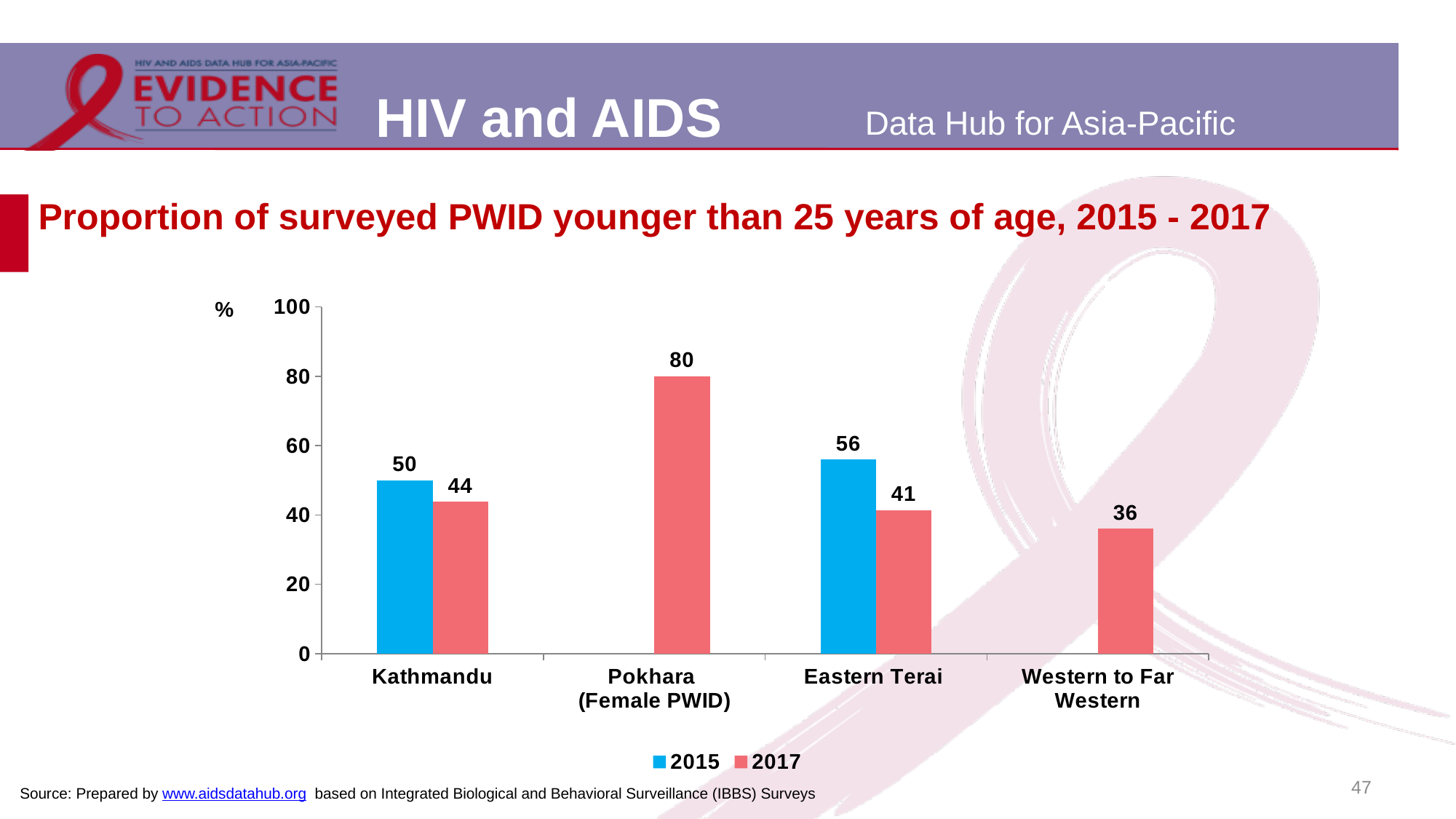
How many categories are shown on the x axis? 4 Which category has the highest 2017 value? Pokhara (Female PWID) What is the 2015 value for Kathmandu? 50 Which category has the lowest 2017 value? Western to Far Western What is the 2015 value for Eastern Terai? 56 What is the difference between the 2015 and 2017 values for Kathmandu? 6 What is the 2017 value for Pokhara (Female PWID)? 80 What kind of chart is shown on the slide? Bar chart How many series does the legend list? 2 What is the 2017 value for Western to Far Western? 36 What is the difference between the 2015 and 2017 values for Eastern Terai? 15 Which is larger for Kathmandu, the 2015 value or the 2017 value? 2015